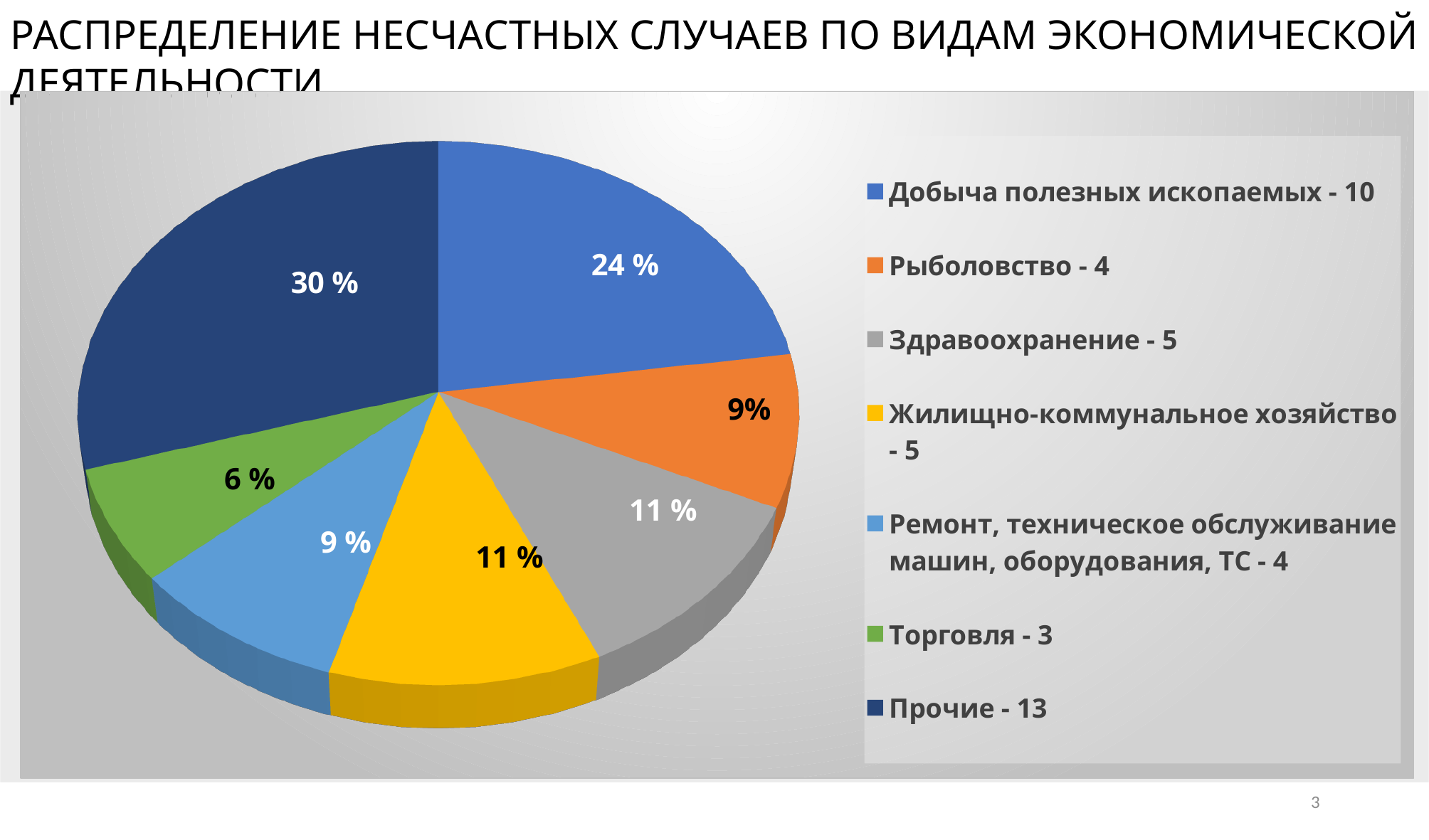
Which category has the largest slice of the pie? Прочие What is the difference in percentage points between the Прочие slice and the Добыча полезных ископаемых slice? 6 What percentage is shown for the Рыболовство slice? 9% How many accidents does the legend list for Прочие? 13 What percentage is shown for the Добыча полезных ископаемых slice? 24 % Which slice is larger, Здравоохранение or Торговля? Здравоохранение How many categories does the pie chart have? 7 What percentage is shown for the Торговля slice? 6 % How many accidents does the legend list for Здравоохранение? 5 What share of the pie is labelled for Прочие? 30 % What type of chart is shown on the slide? Pie chart Which category has the smallest slice of the pie? Торговля